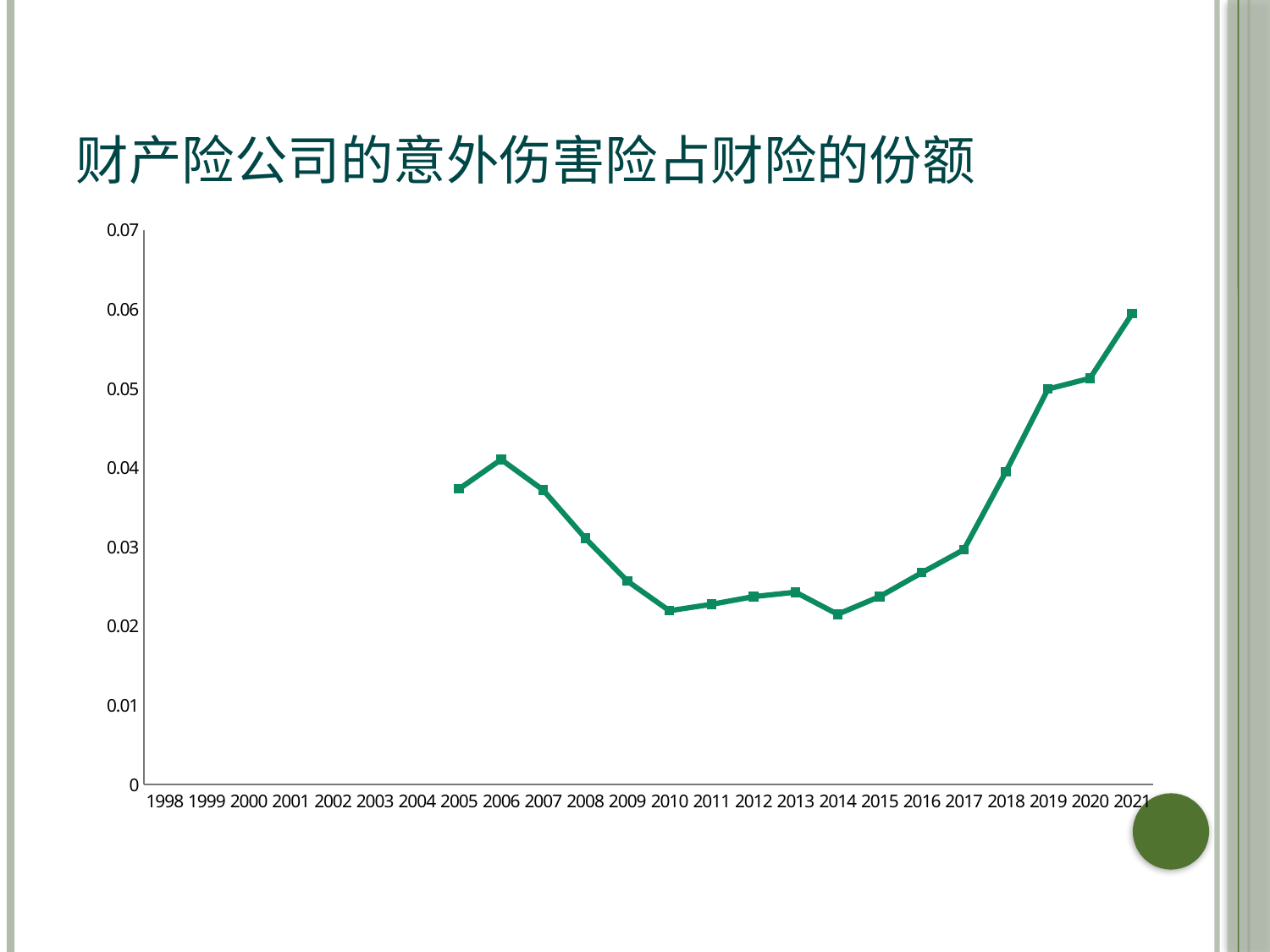
Is the value for 2010 greater or less than 0.03? less What is the title of the chart? 财产险公司的意外伤害险占财险的份额 Which year has the highest value on the chart? 2021 Do the values rise or fall from 2006 to 2010? fall Is the value for 2021 greater or less than 0.05? greater Is the value for 2017 greater or less than 0.04? less What kind of chart is shown on the slide? line chart Do the values rise or fall from 2017 to 2021? rise Which year has the larger value, 2018 or 2019? 2019 Which year has the larger value, 2006 or 2009? 2006